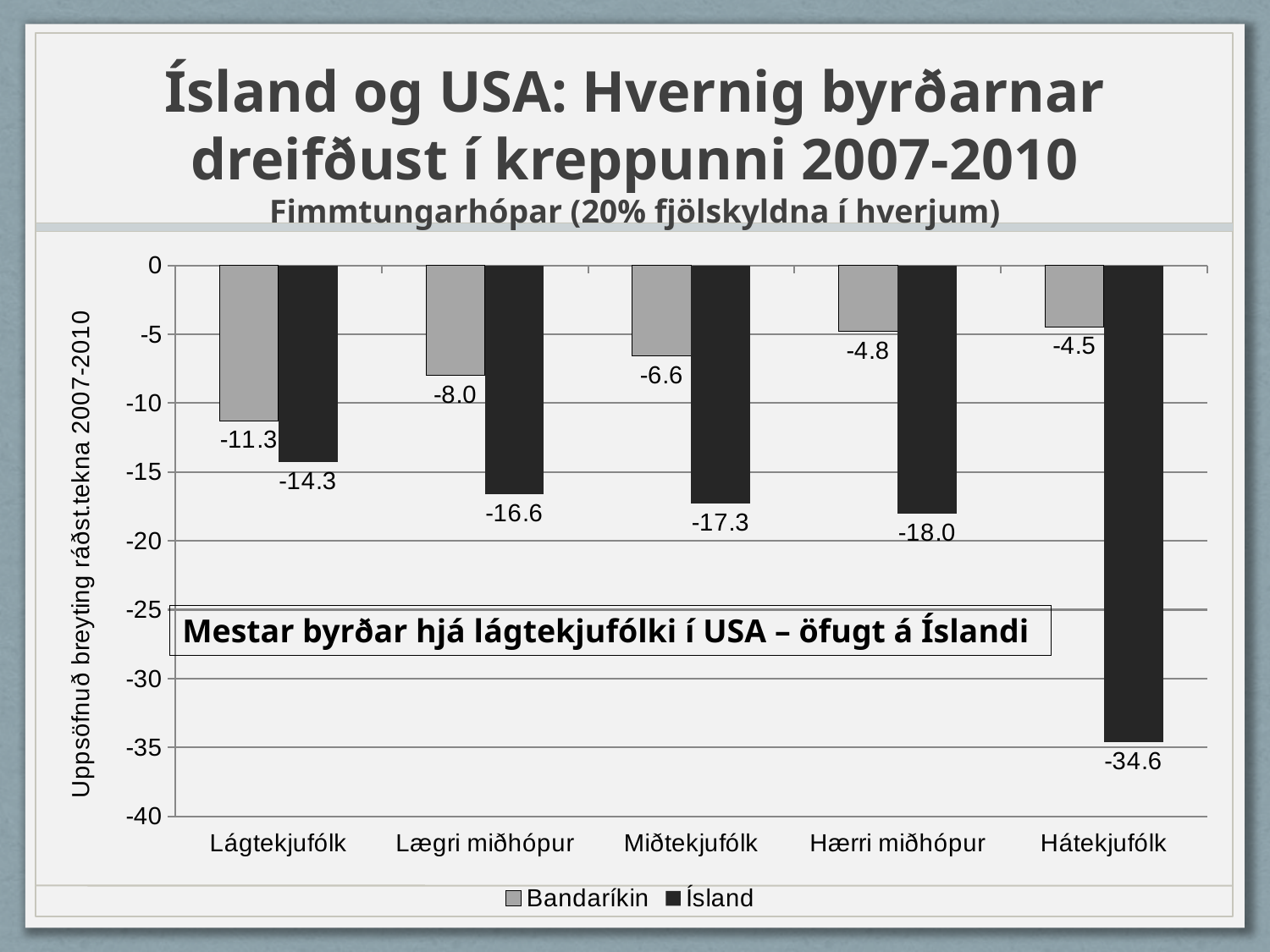
Do the Bandaríkin values become less negative or more negative moving from Lágtekjufólk to Hátekjufólk? Less negative What is the value for Bandaríkin in the Lágtekjufólk category? -11.3 Which series has the more negative value in the Lægri miðhópur category, Bandaríkin or Ísland? Ísland What is the value for Ísland in the Hátekjufólk category? -34.6 What is the value for Bandaríkin in the Hærri miðhópur category? -4.8 Which category has the most negative value for the Ísland series? Hátekjufólk What is the value for Ísland in the Miðtekjufólk category? -17.3 What kind of chart is shown on the slide? Bar chart How many series does the legend list? 2 What is the difference between the Ísland and Bandaríkin values in the Lágtekjufólk category? 3.0 How many categories are shown on the x axis? 5 Which category has the value closest to zero for the Bandaríkin series? Hátekjufólk